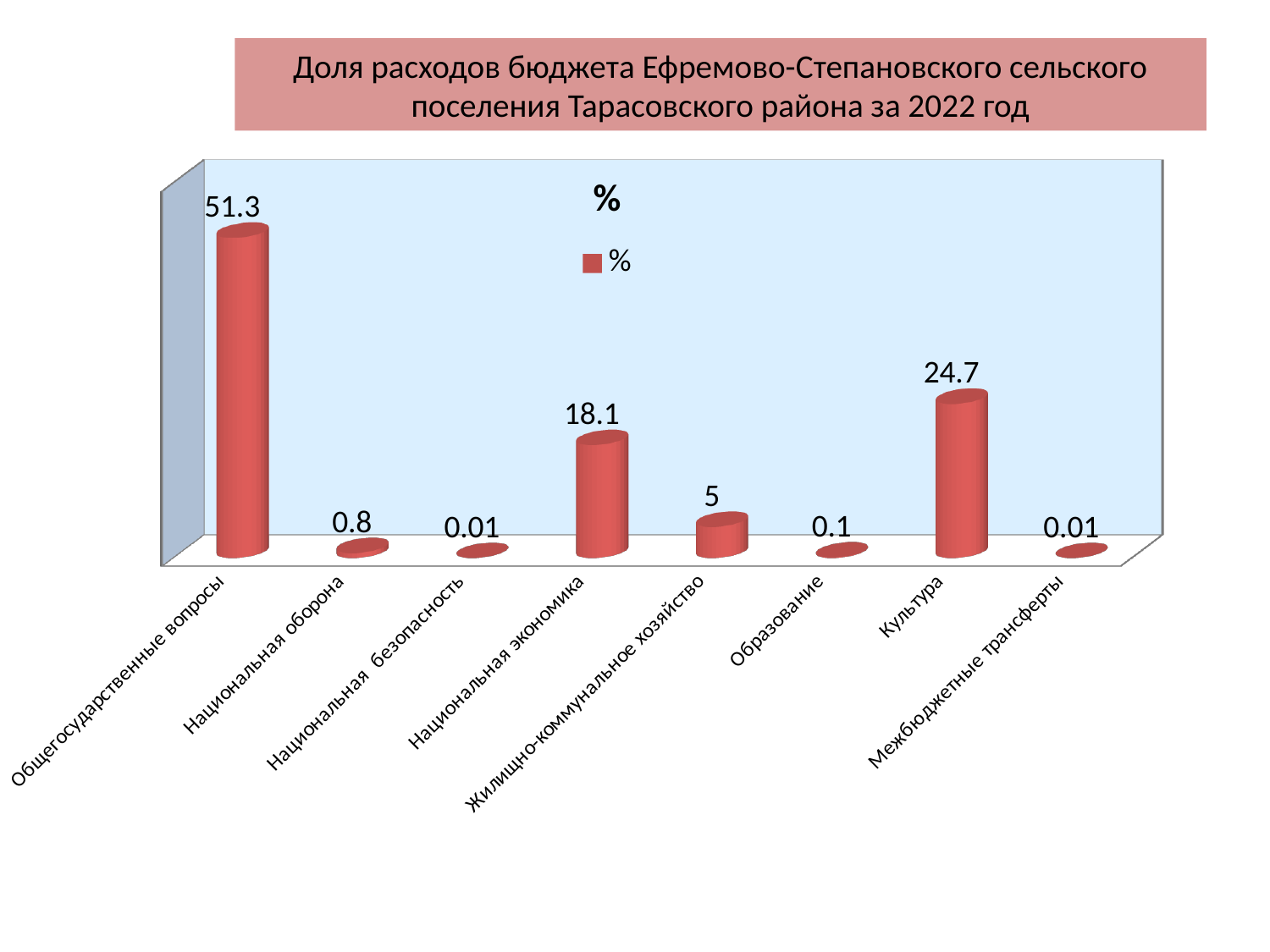
What is the value for Национальная оборона? 0.8 How many series does the legend list? 1 Which is larger, the value for Национальная экономика or the value for Жилищно-коммунальное хозяйство? Национальная экономика How many categories are shown on the x axis? 8 What is the value for Жилищно-коммунальное хозяйство? 5 Which category has the highest value? Общегосударственные вопросы What kind of chart is shown on the slide? bar chart What is the difference between the values for Общегосударственные вопросы and Культура? 26.6 What is the value for Культура? 24.7 What is the value for Общегосударственные вопросы? 51.3 What is the value for Национальная экономика? 18.1 What is the difference between the values for Культура and Национальная экономика? 6.6